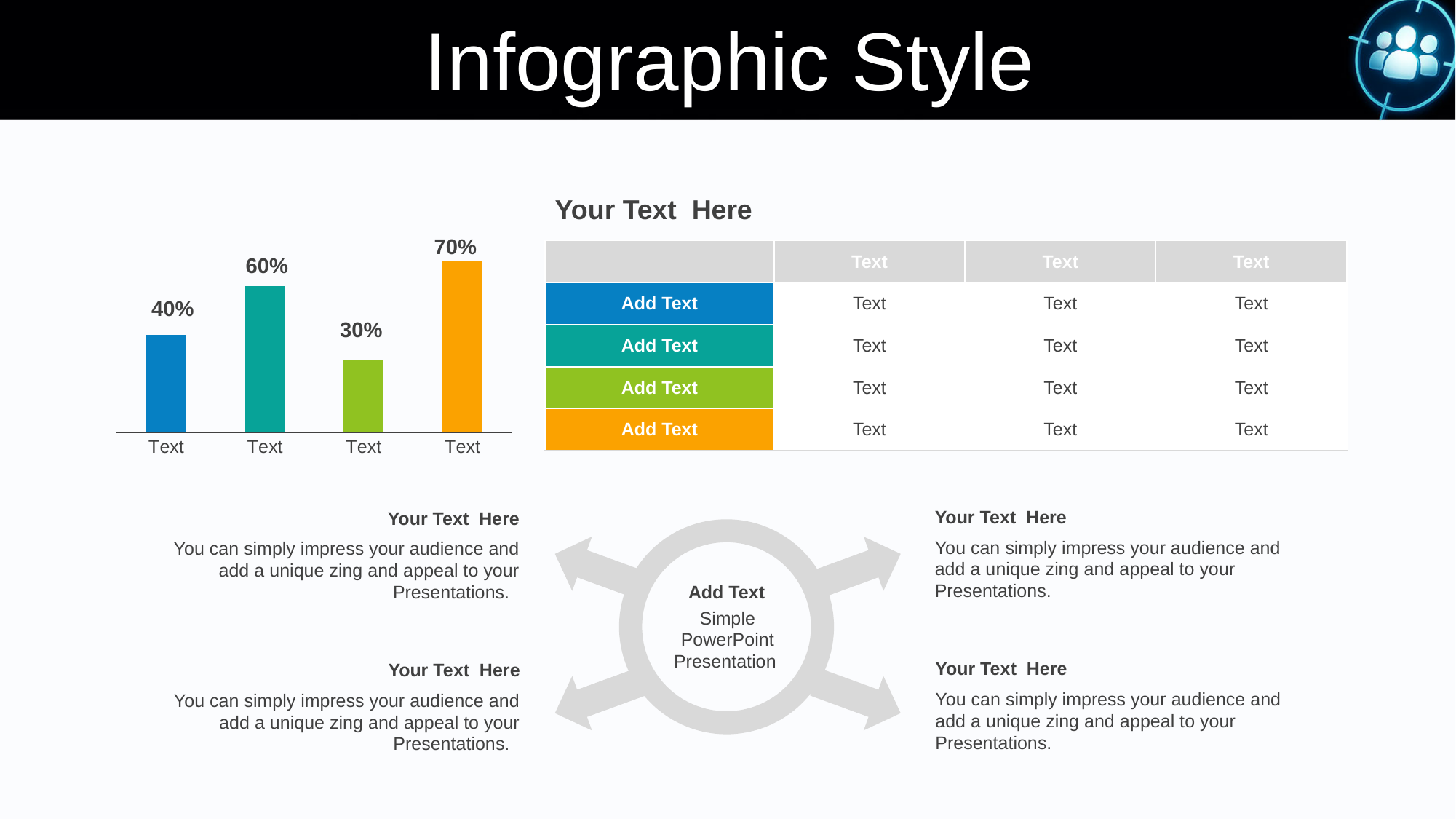
What is the value of the first (blue) bar in the bar chart? 40% How many bars does the bar chart have? 4 Which bar in the bar chart has the highest value? the fourth (orange) bar, 70% What colour is the tallest bar in the bar chart? orange Which bar in the bar chart has the lowest value? the third (green) bar, 30% What is the value of the third (green) bar in the bar chart? 30% What is the value of the second (teal) bar in the bar chart? 60% Which is larger in the bar chart, the first (blue) bar or the second (teal) bar? the second (teal) bar What kind of chart is shown on the left of the slide? bar chart What is the difference between the second (teal) bar and the first (blue) bar in the bar chart? 20% What is the difference between the fourth (orange) bar and the third (green) bar in the bar chart? 40% What is the value of the fourth (orange) bar in the bar chart? 70%